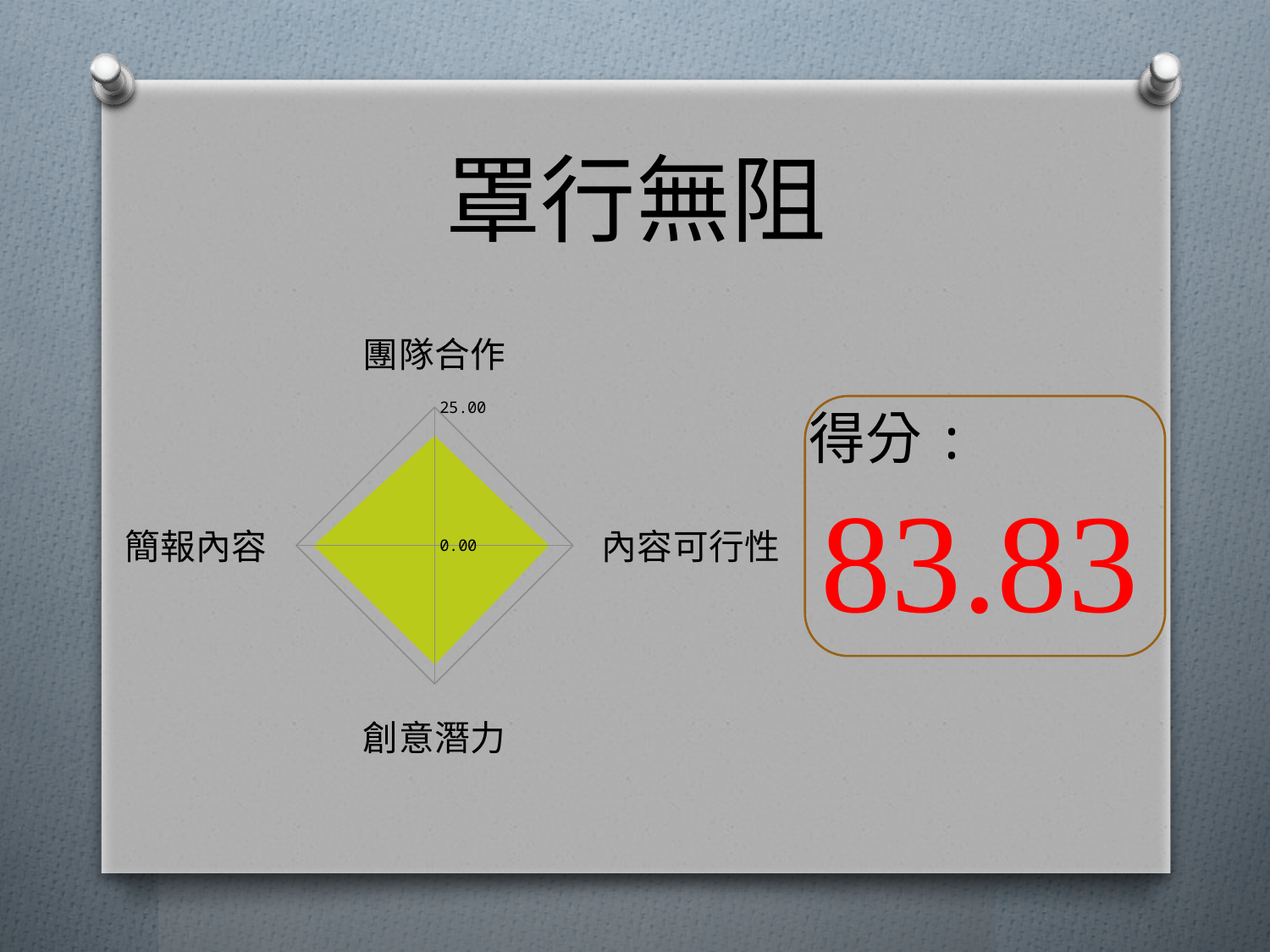
How many categories (axes) does the radar chart have? 4 Is the value for 團隊合作 greater or less than 25.00? less What kind of chart is shown on the slide? radar chart Which category label appears at the bottom of the radar chart? 創意潛力 Is the value for 創意潛力 greater or less than 0.00? greater Which category label appears at the top of the radar chart? 團隊合作 What is the maximum value shown on the radar chart's axis? 25.00 Is the value for 內容可行性 greater or less than 25.00? less